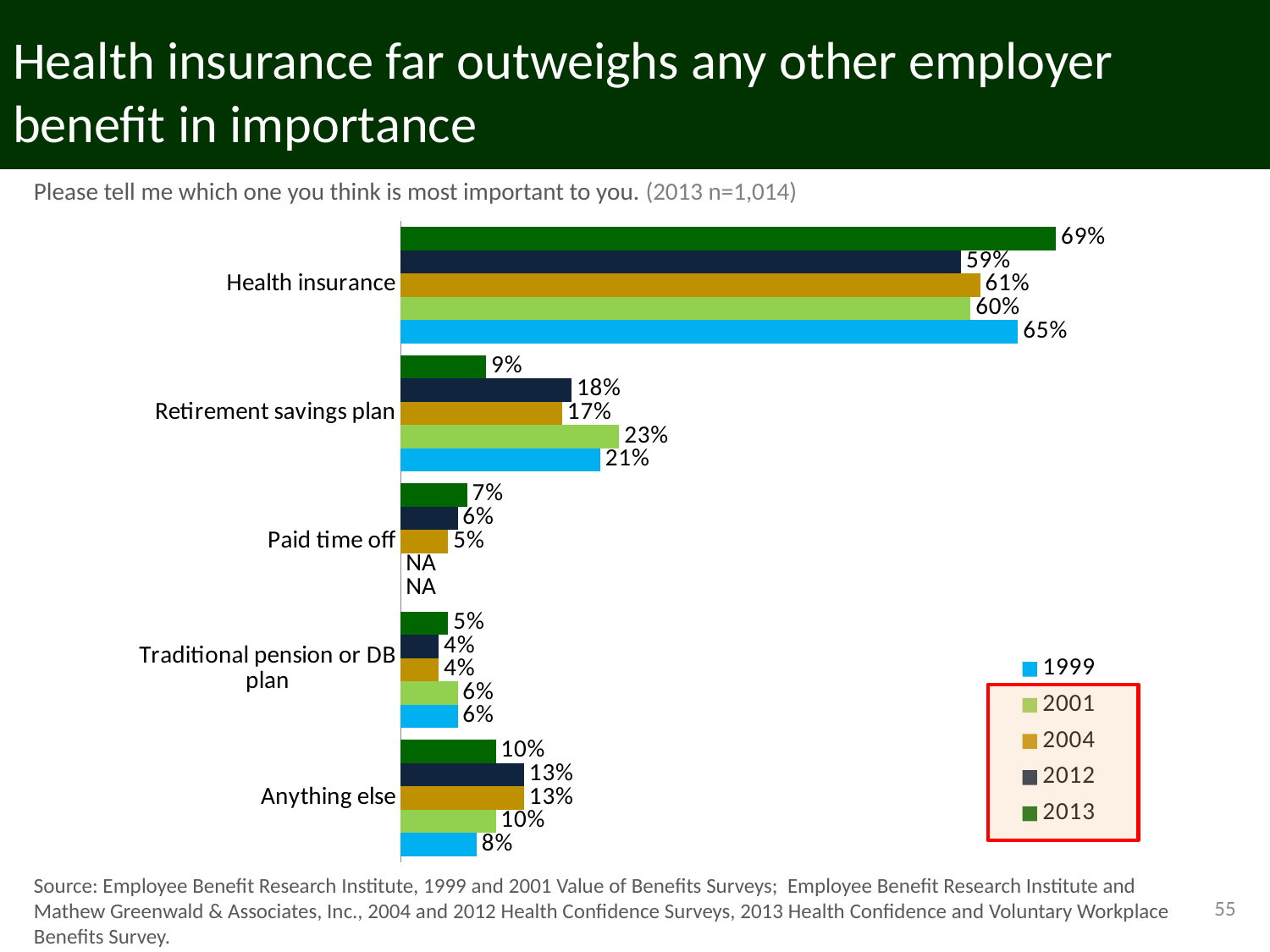
How many series does the legend list? 5 What is the 2004 value for Paid time off? 5% What is the difference between the 2013 and 2012 values for Health insurance? 10% For Retirement savings plan, which year has the larger value, 2001 or 2013? 2001 How many categories are shown on the chart? 5 What is the 2012 value for Anything else? 13% What is the 1999 value for Retirement savings plan? 21% What kind of chart is shown on the slide? Bar chart What value is shown for Paid time off in the 1999 and 2001 series? NA Which category has the lowest value in the 2012 series? Traditional pension or DB plan What percentage of respondents in 2013 said health insurance is the most important employer benefit? 69% Which category has the highest value in the 2013 series? Health insurance